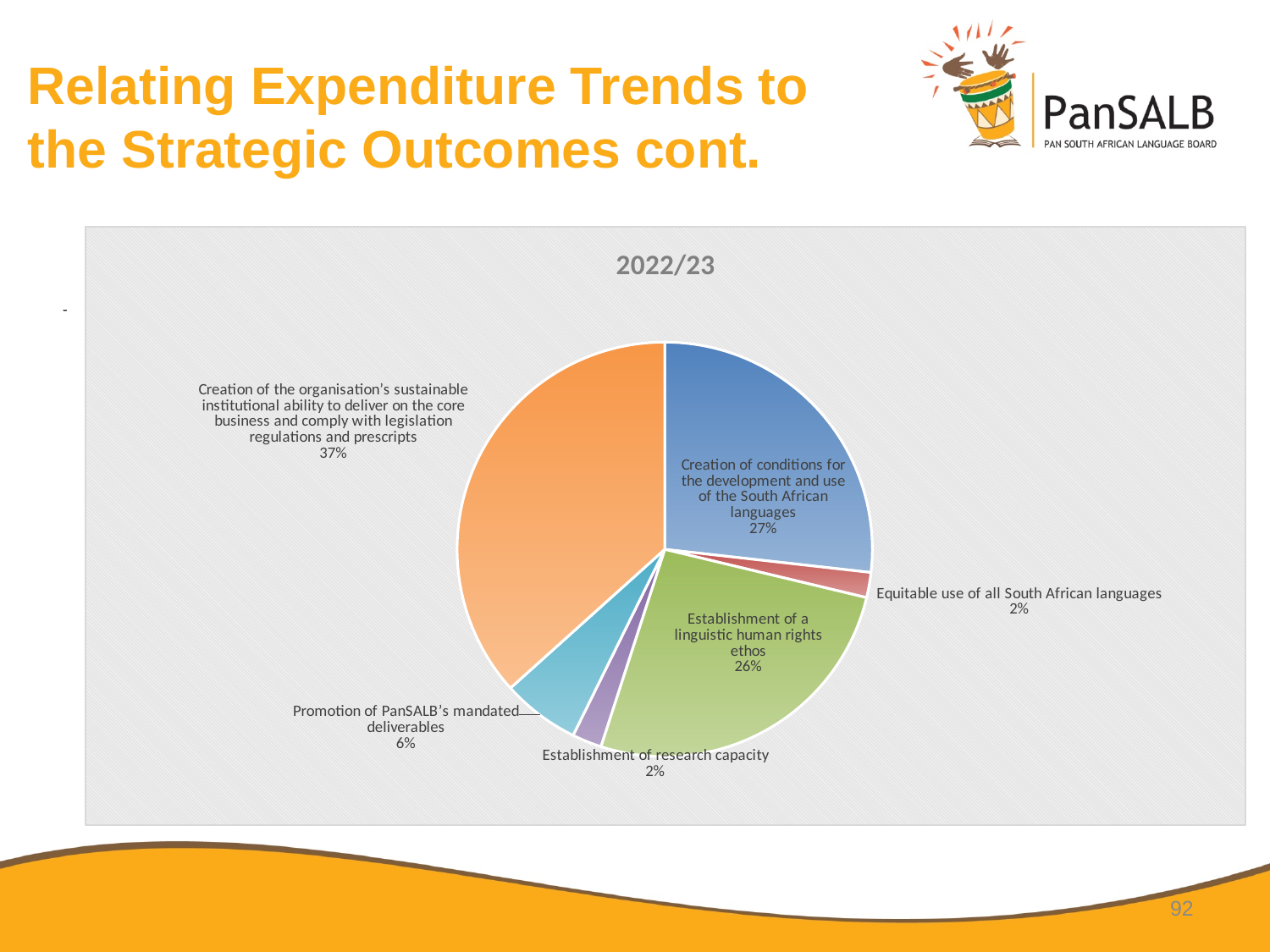
What is the title of the chart? 2022/23 What is the combined share of 'Establishment of research capacity' and 'Equitable use of all South African languages'? 4% What share of the pie is 'Promotion of PanSALB's mandated deliverables'? 6% Which is larger: the share for 'Creation of conditions for the development and use of the South African languages' or the share for 'Promotion of PanSALB's mandated deliverables'? Creation of conditions for the development and use of the South African languages What share of the pie is 'Establishment of a linguistic human rights ethos'? 26% How many slices does the pie chart have? 6 What is the difference in percentage points between the largest slice (37%) and 'Establishment of a linguistic human rights ethos' (26%)? 11 percentage points What colour is the slice for 'Establishment of a linguistic human rights ethos'? Green What type of chart is shown on the slide? Pie chart What share of the pie is 'Creation of conditions for the development and use of the South African languages'? 27% Which category has the largest share of the pie? Creation of the organisation's sustainable institutional ability to deliver on the core business and comply with legislation regulations and prescripts